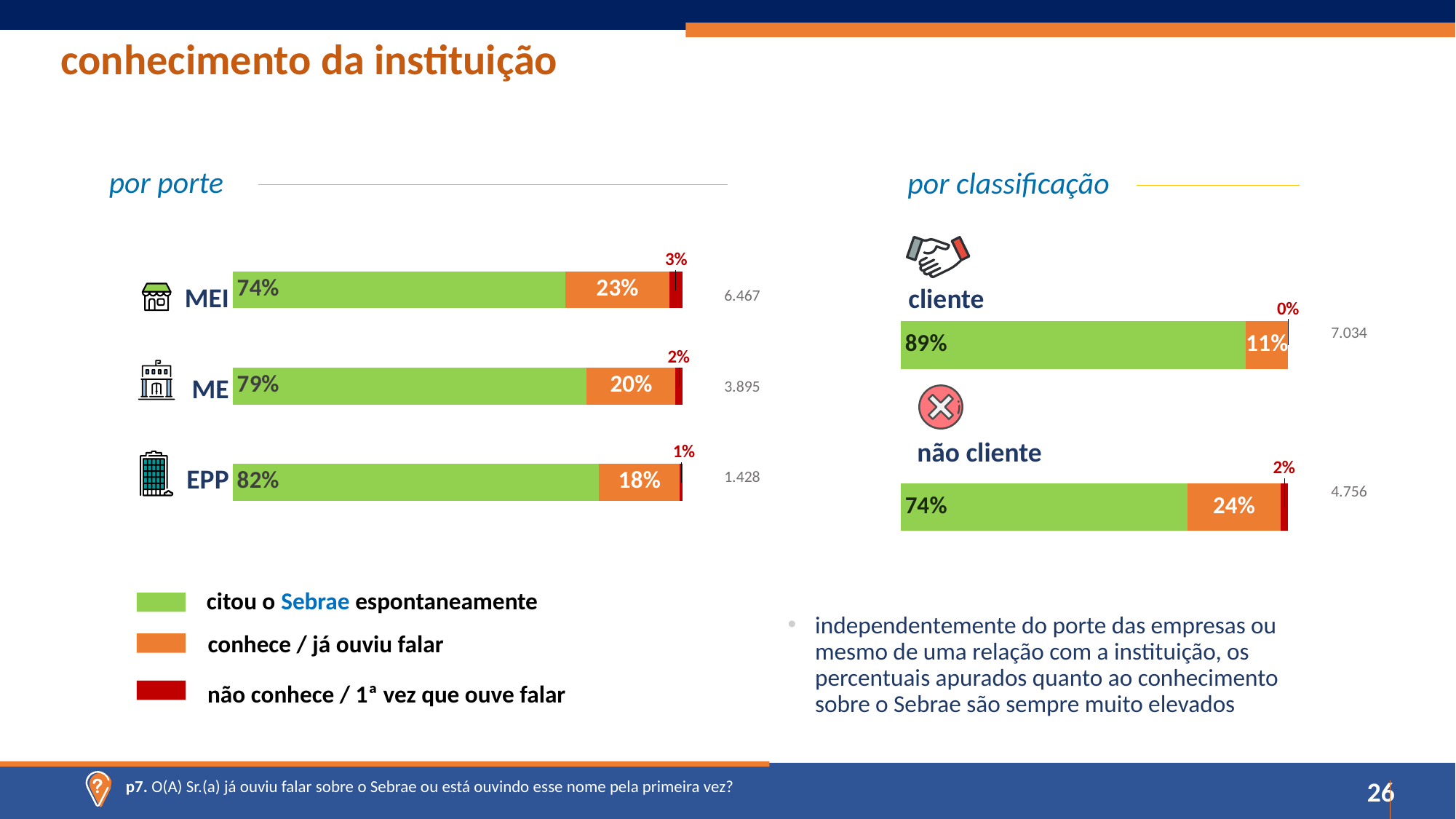
In the 'por porte' chart, what is the 'conhece / já ouviu falar' value for ME? 20% In the 'por porte' chart, which category has the highest 'citou o Sebrae espontaneamente' percentage? EPP In the 'por classificação' chart, what percentage of 'cliente' respondents cited Sebrae spontaneously? 89% In the 'por porte' chart, what is the 'não conhece / 1ª vez que ouve falar' value for EPP? 1% What type of chart is used in the 'por porte' section? Stacked bar chart In the 'por porte' chart, what percentage of MEI respondents cited Sebrae spontaneously ('citou o Sebrae espontaneamente')? 74% In the 'por classificação' chart, what is the sample size (n) shown next to the 'cliente' bar? 7.034 In the 'por porte' chart, what is the difference between the 'citou o Sebrae espontaneamente' percentages for EPP and MEI? 8 percentage points In the 'por porte' chart, which category has the lowest 'citou o Sebrae espontaneamente' percentage? MEI In the 'por classificação' chart, which group has the larger 'conhece / já ouviu falar' share, cliente or não cliente? não cliente In the 'por classificação' chart, what is the 'conhece / já ouviu falar' value for 'não cliente'? 24% How many series does the legend list for the charts on this slide? 3